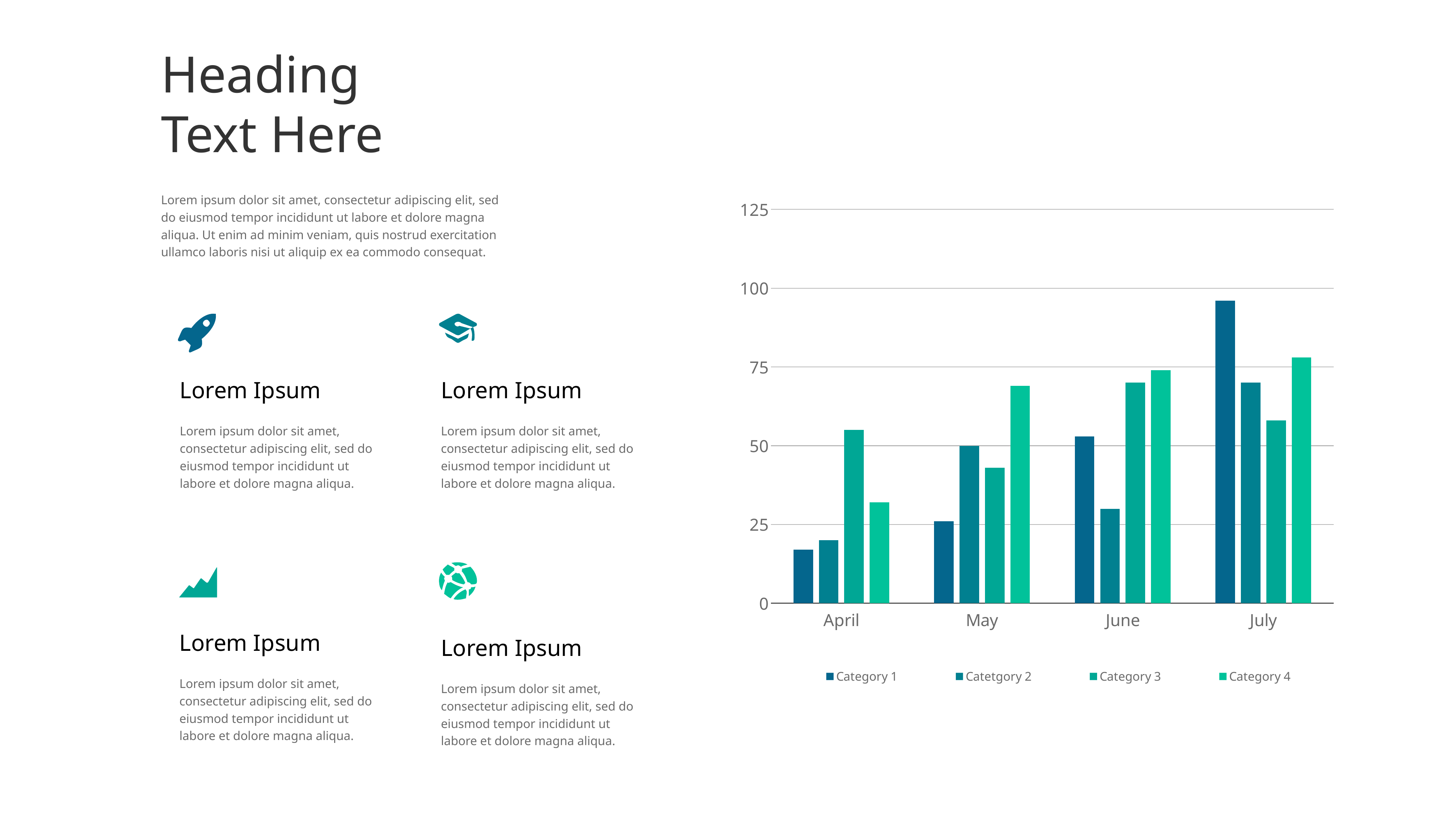
How many series does the chart's legend list? 4 Is the value for Category 3 in June greater or less than 50? greater Do the values for Category 1 rise or fall from April to July? rise Which is larger: Category 4 in May or Category 4 in April? Category 4 in May In which month does Category 1 reach its highest value? July How many months are shown along the x axis of the chart? 4 Is the value for Category 1 in April greater or less than 25? less What kind of chart is shown on the slide? bar chart Is the value for Category 1 in July greater or less than 75? greater Which series has the lowest bar in June? Catetgory 2 What is the second entry in the chart's legend? Catetgory 2 Which series has the highest bar in April? Category 3